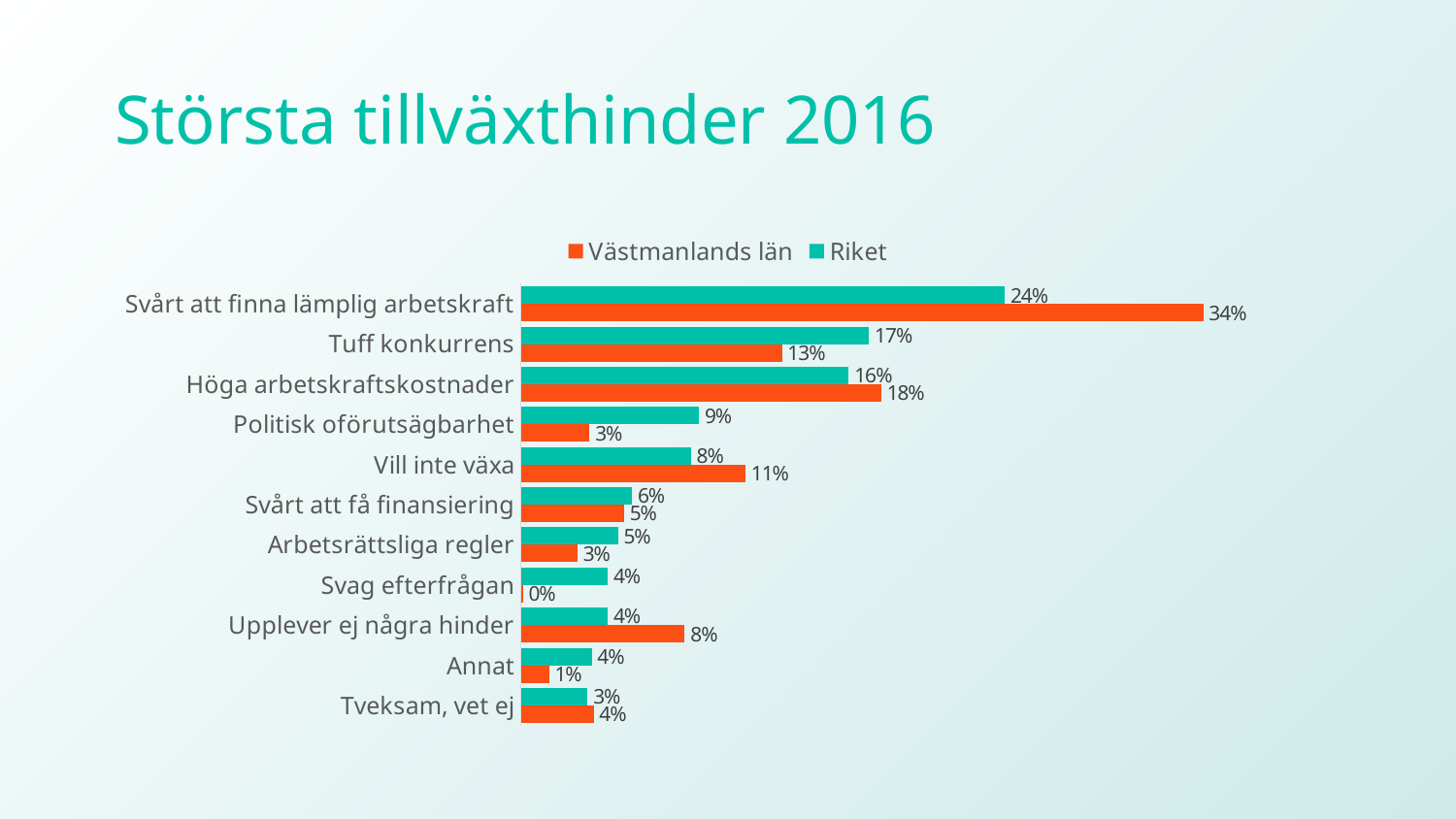
Which category has the highest value for Riket? Svårt att finna lämplig arbetskraft For 'Vill inte växa', which series has the larger value, Västmanlands län or Riket? Västmanlands län What kind of chart is shown on the slide? Bar chart What is the difference between Riket and Västmanlands län for 'Politisk oförutsägbarhet'? 6% What is the value for Västmanlands län for 'Upplever ej några hinder'? 8% For 'Tuff konkurrens', which series has the larger value, Västmanlands län or Riket? Riket How many categories are shown in the chart? 11 What is the difference between Västmanlands län and Riket for 'Svårt att finna lämplig arbetskraft'? 10% What is the value for Riket for 'Politisk oförutsägbarhet'? 9% What is the value for Västmanlands län for 'Svårt att finna lämplig arbetskraft'? 34% Which category has the lowest value for Västmanlands län? Svag efterfrågan How many series does the legend list? 2